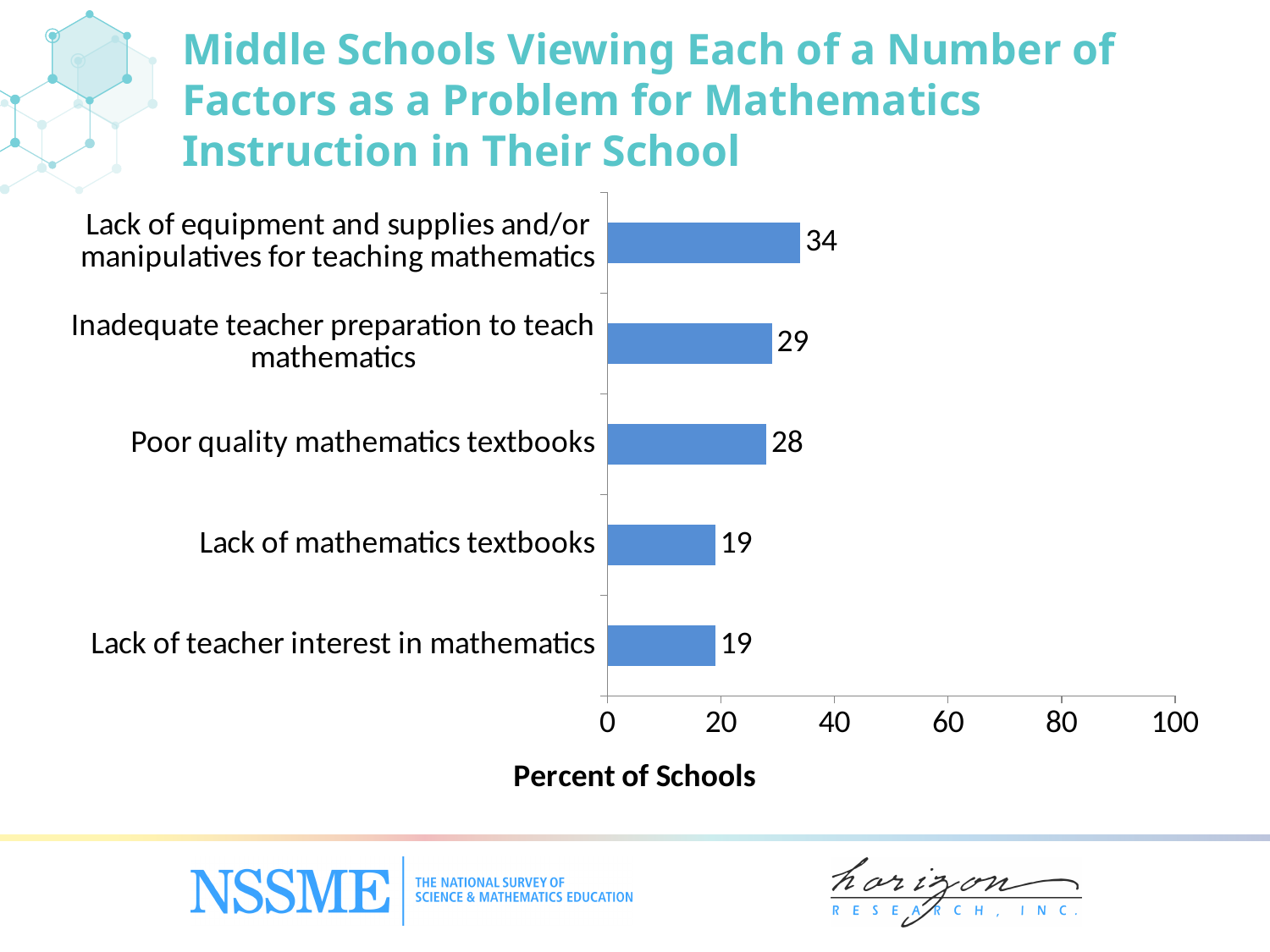
Which is larger: the value for inadequate teacher preparation to teach mathematics or the value for lack of mathematics textbooks? Inadequate teacher preparation to teach mathematics Is the value for poor quality mathematics textbooks greater or less than 40? less What kind of chart is shown on the slide? Bar chart How many factors are shown in the chart? 5 Which factor has the highest percent of schools viewing it as a problem? Lack of equipment and supplies and/or manipulatives for teaching mathematics What is the value for poor quality mathematics textbooks? 28 What is the maximum value shown on the horizontal axis? 100 What is the value for inadequate teacher preparation to teach mathematics? 29 What is the label of the horizontal axis? Percent of Schools What is the value for lack of teacher interest in mathematics? 19 What is the difference between the values for lack of equipment and supplies and/or manipulatives and lack of mathematics textbooks? 15 What percent of middle schools view lack of equipment and supplies and/or manipulatives for teaching mathematics as a problem? 34